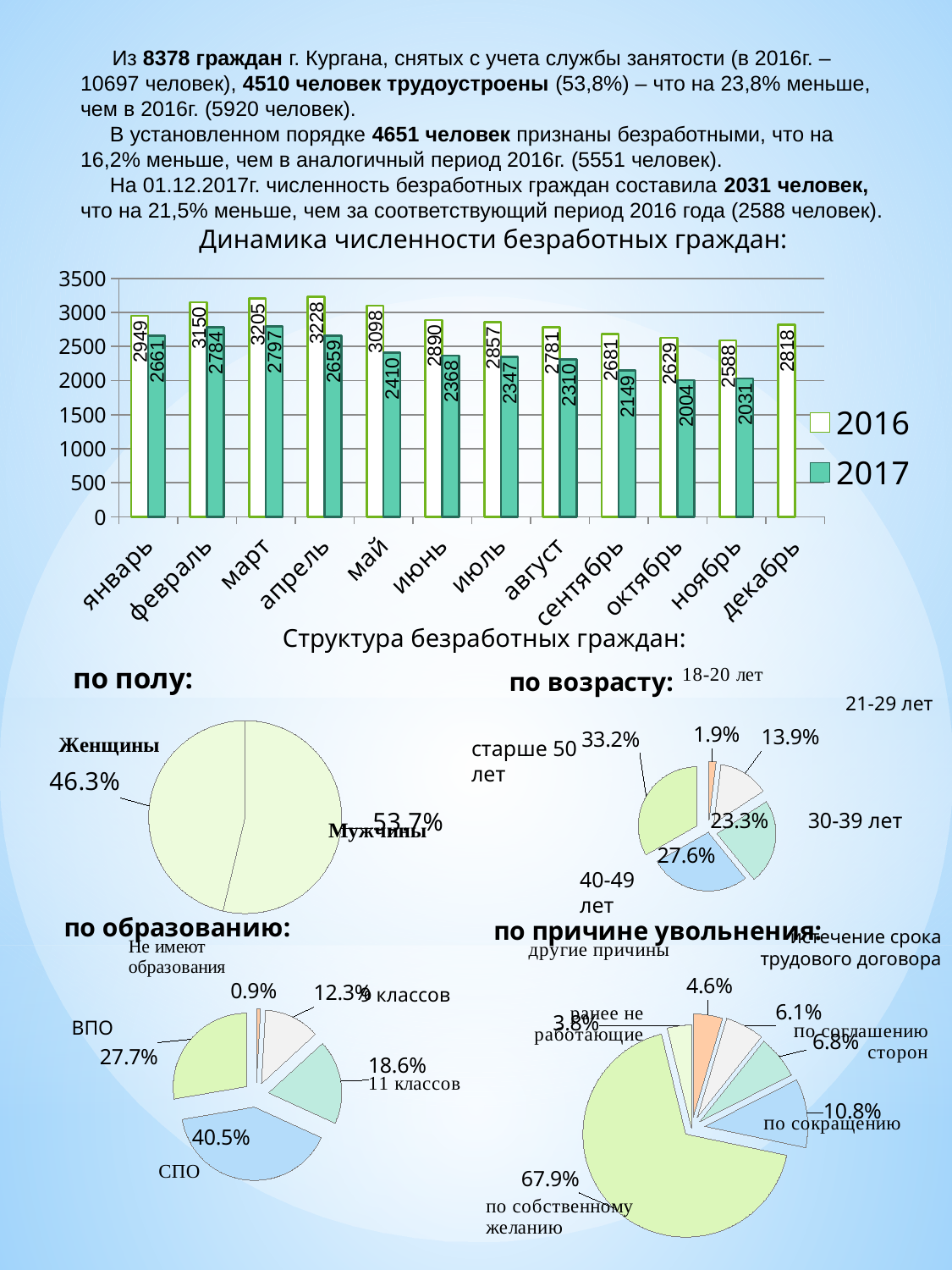
In the chart 'Динамика численности безработных граждан', which month has the highest value for the 2017 series? март In the chart 'Динамика численности безработных граждан', what is the value for 2016 in апрель? 3228 In the pie chart 'по причине увольнения', which is larger: по сокращению or по соглашению сторон? по сокращению In the pie chart 'по возрасту', which age group has the largest share? старше 50 лет What kind of chart is 'Динамика численности безработных граждан'? bar chart In the chart 'Динамика численности безработных граждан', what is the difference between the 2016 and 2017 values in май? 688 In the pie chart 'по полу', what share is Женщины? 46.3% In the pie chart 'по образованию', what share is СПО? 40.5% In the chart 'Динамика численности безработных граждан', do the 2017 values generally rise or fall from январь to ноябрь? fall In the chart 'Динамика численности безработных граждан', what is the value for 2017 in октябрь? 2004 In the chart 'Динамика численности безработных граждан', which month has the lowest value for the 2016 series? ноябрь In the chart 'Динамика численности безработных граждан', how many series does the legend list? 2